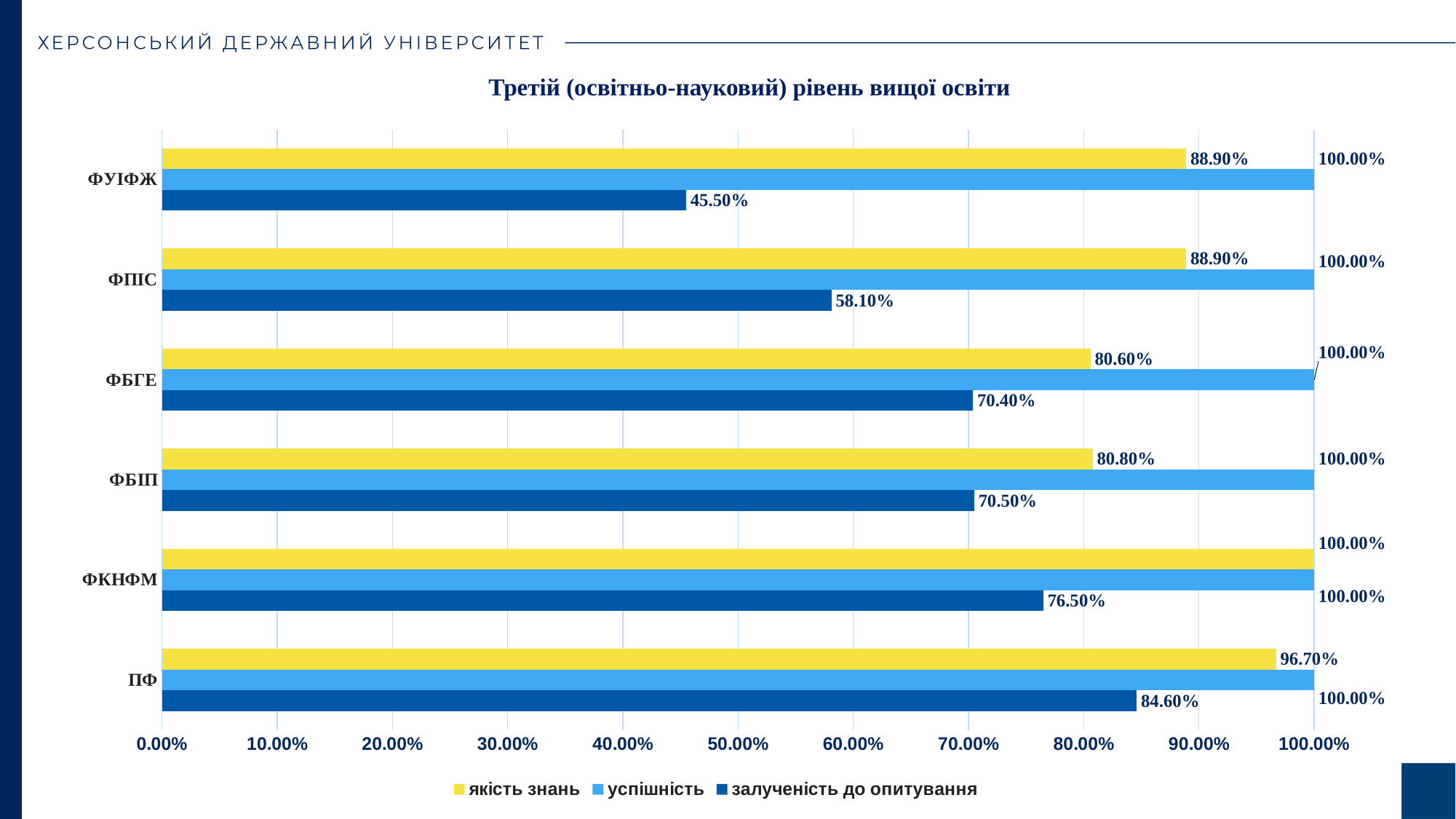
What is the value of залученість до опитування for ФПІС? 58.10% What is the value of залученість до опитування for ФУІФЖ? 45.50% Which faculty has the lowest залученість до опитування? ФУІФЖ What is the value of якість знань for ФКНФМ? 100.00% What is the difference between якість знань for ПФ and якість знань for ФБГЕ? 16.10% What kind of chart is shown on the slide? bar chart Which is larger: залученість до опитування for ФКНФМ or for ФБІП? ФКНФМ How many faculties (categories) are shown on the chart? 6 What is the title of the chart? Третій (освітньо-науковий) рівень вищої освіти What is the value of якість знань for ПФ? 96.70% Which faculty has the highest залученість до опитування? ПФ How many series does the legend list? 3